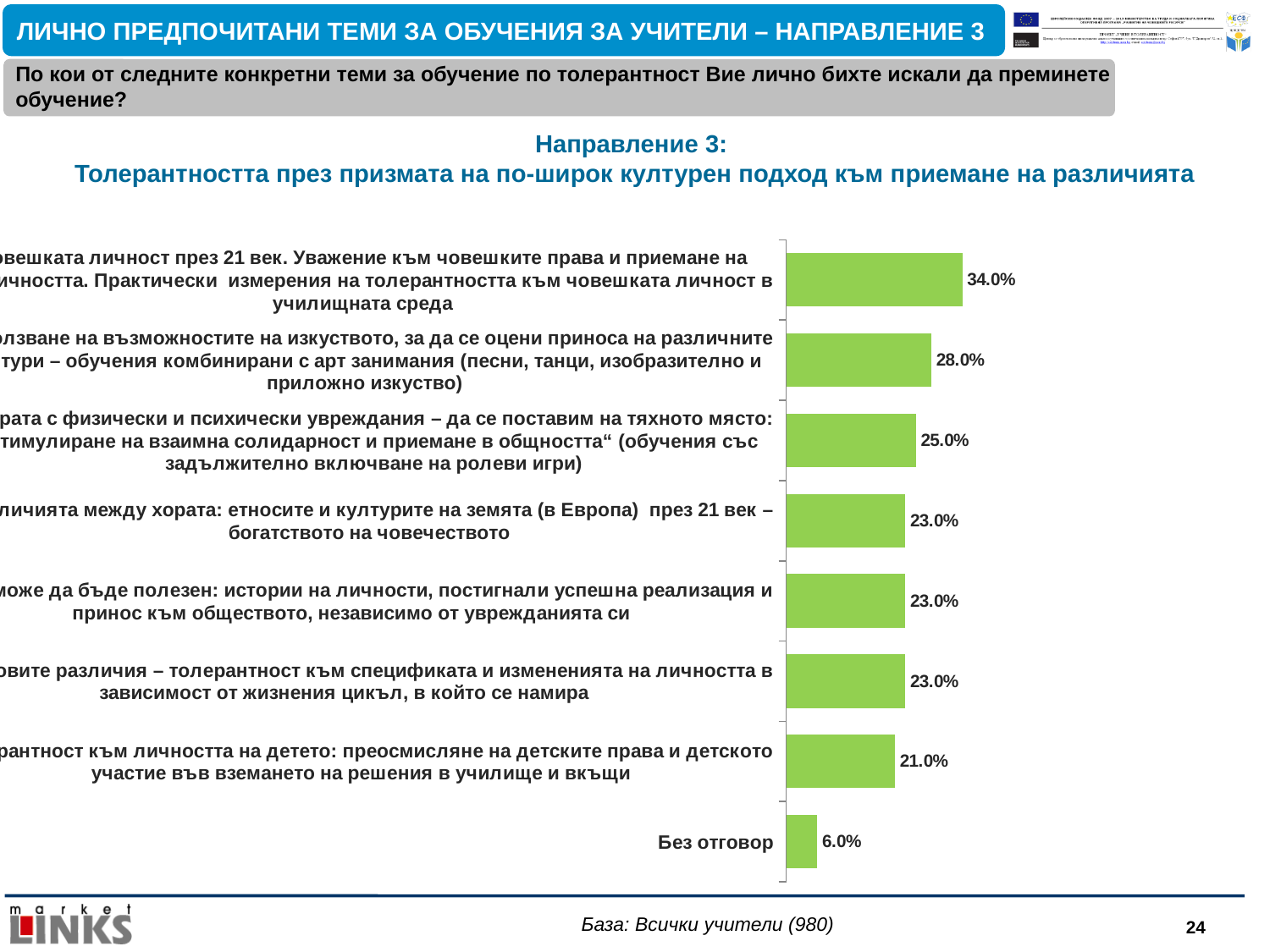
Which category has the lowest value in the chart? Без отговор What is the value for the category "Без отговор"? 6.0% How many bars (categories) does the chart show? 8 What type of chart is shown on the slide? bar chart What is the value for the category ending in "приложно изкуство)"? 28.0% What is the value of the top bar in the chart (the category ending in "училищната среда")? 34.0% How many categories in the chart have a value of exactly 23.0%? 3 What is the difference between the highest value (34.0%) and the value for "Без отговор" (6.0%)? 28.0% What is the value for the category ending in "участие във вземането на решения в училище и вкъщи"? 21.0% What is the value for the category ending in "богатството на човечеството"? 23.0% Which is larger: the value for the category ending in "приложно изкуство)" or the value for the category ending in "задължително включване на ролеви игри)"? the category ending in "приложно изкуство)" (28.0%) What is the value for the category ending in "задължително включване на ролеви игри)"? 25.0%